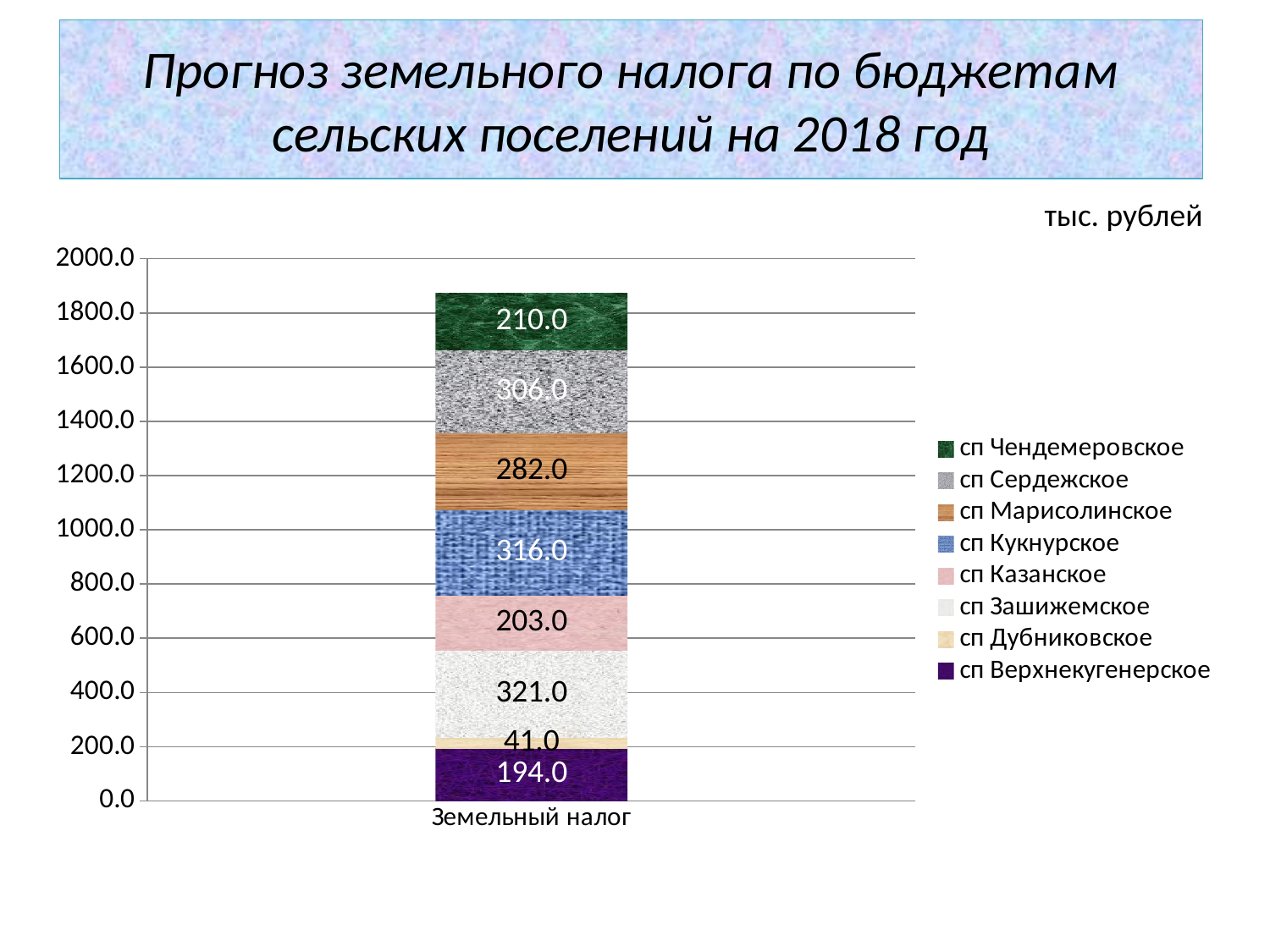
What is the value for сп Марисолинское? 282.0 What is the value for сп Кукнурское in the stacked bar? 316.0 Which is larger, the value for сп Чендемеровское or the value for сп Верхнекугенерское? сп Чендемеровское Which settlement has the smallest value in the stacked bar? сп Дубниковское What is the value for сп Верхнекугенерское? 194.0 Which settlement has the largest value in the stacked bar? сп Зашижемское What is the total of the stacked bar for Земельный налог? 1873.0 How many series does the legend list? 8 What is the value for сп Дубниковское? 41.0 What is the difference between the values for сп Сердежское and сп Казанское? 103.0 What unit is indicated above the chart? тыс. рублей What kind of chart is shown on the slide? Stacked bar chart